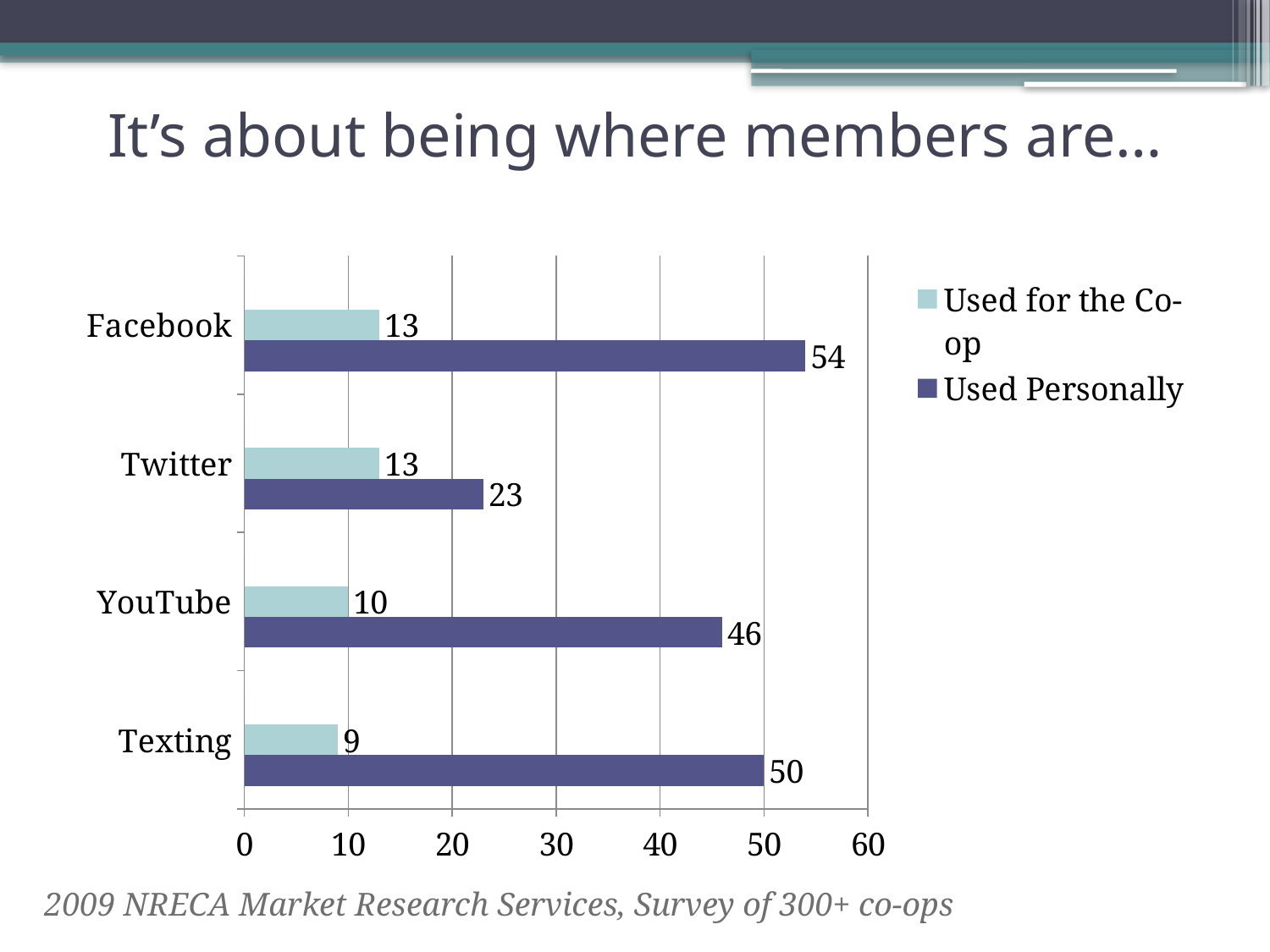
Is the 'Used Personally' value for Twitter greater or less than 30? less Which is larger: the 'Used Personally' value for Texting or for YouTube? Texting What is the difference between the 'Used Personally' and 'Used for the Co-op' values for YouTube? 36 What is the 'Used Personally' value for Twitter? 23 What kind of chart is shown on the slide? bar chart What is the 'Used for the Co-op' value for Texting? 9 How many categories are shown on the chart? 4 Which category has the lowest 'Used for the Co-op' value? Texting What is the 'Used Personally' value for Facebook? 54 Which category has the highest 'Used Personally' value? Facebook What is the title of the slide? It's about being where members are... How many series does the legend list? 2